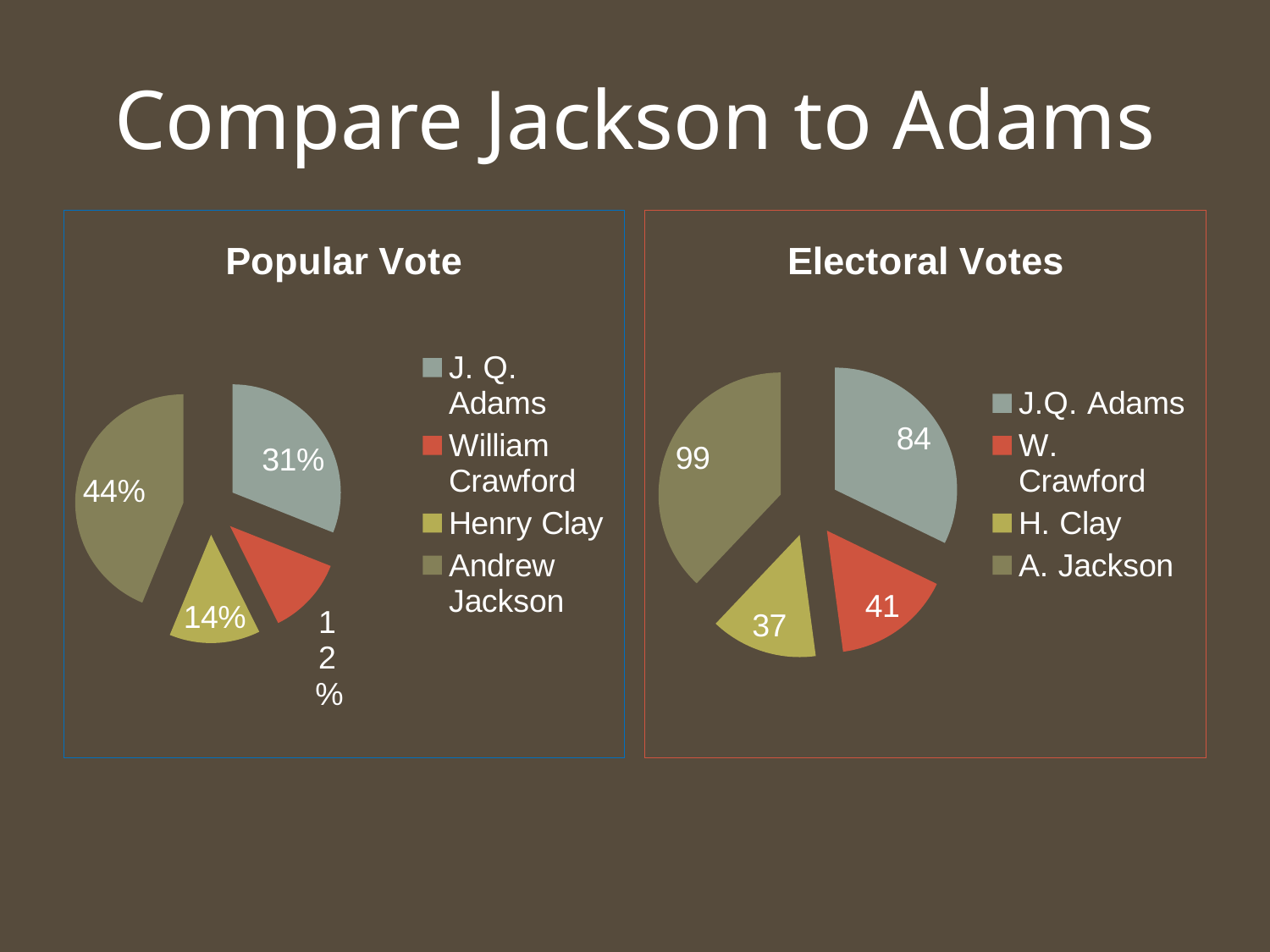
In the Electoral Votes chart, which candidate has the fewest electoral votes? H. Clay In the Electoral Votes chart, who has more electoral votes, W. Crawford or H. Clay? W. Crawford In the Popular Vote chart, what percentage is shown for Andrew Jackson? 44% In the Electoral Votes chart, how many electoral votes did A. Jackson receive? 99 In the Popular Vote chart, which candidate has the smallest share? William Crawford What type of chart is the Electoral Votes chart? Pie chart In the Popular Vote chart, what percentage is shown for J. Q. Adams? 31% In the Popular Vote chart, how many candidates are shown? 4 In the Electoral Votes chart, how many electoral votes did H. Clay receive? 37 In the Electoral Votes chart, which candidate has the most electoral votes? A. Jackson In the Popular Vote chart, what is the difference in percentage points between Andrew Jackson and J. Q. Adams? 13 In the Electoral Votes chart, what is the difference between A. Jackson's and J.Q. Adams's electoral votes? 15